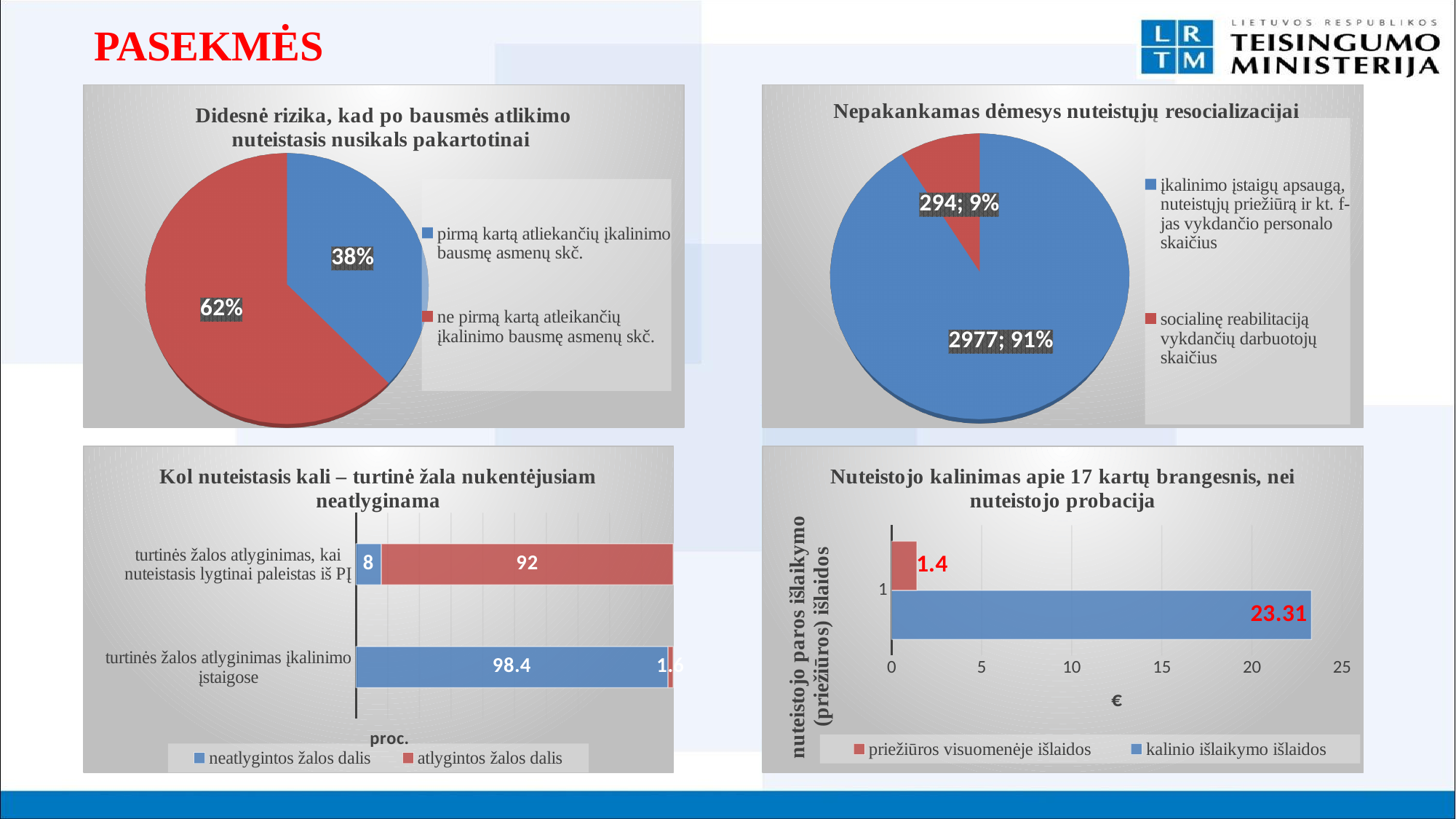
In the bottom-left chart 'Kol nuteistasis kali – turtinė žala nukentėjusiam neatlyginama', what is the value of 'neatlygintos žalos dalis' for 'turtinės žalos atlyginimas įkalinimo įstaigose'? 98.4 In the top-right pie chart, what percentage share does 'įkalinimo įstaigų apsaugą, nuteistųjų priežiūrą ir kt. f-jas vykdančio personalo skaičius' have? 91% In the bottom-left chart, what is the value of 'atlygintos žalos dalis' for 'turtinės žalos atlyginimas, kai nuteistasis lygtinai paleistas iš PĮ'? 92 How many series does the legend of the bottom-left chart list? 2 In the bottom-right chart, what is the difference between 'kalinio išlaikymo išlaidos' and 'priežiūros visuomenėje išlaidos'? 21.91 In the bottom-right chart 'Nuteistojo kalinimas apie 17 kartų brangesnis, nei nuteistojo probacija', what is the value for 'kalinio išlaikymo išlaidos'? 23.31 In the top-right pie chart, what is the difference between the two slice values (2977 and 294)? 2683 In the top-left pie chart, which slice is larger: 'pirmą kartą atliekančių' or 'ne pirmą kartą atleikančių'? ne pirmą kartą atleikančių In the bottom-left chart, what is the total of the stacked bar for 'turtinės žalos atlyginimas įkalinimo įstaigose'? 100 In the top-left chart 'Didesnė rizika, kad po bausmės atlikimo nuteistasis nusikals pakartotinai', what share of the pie is 'ne pirmą kartą atleikančių įkalinimo bausmę asmenų skč.'? 62% What type of chart is the top-right chart 'Nepakankamas dėmesys nuteistųjų resocializacijai'? pie chart In the top-right chart 'Nepakankamas dėmesys nuteistųjų resocializacijai', what is the value for 'socialinę reabilitaciją vykdančių darbuotojų skaičius'? 294